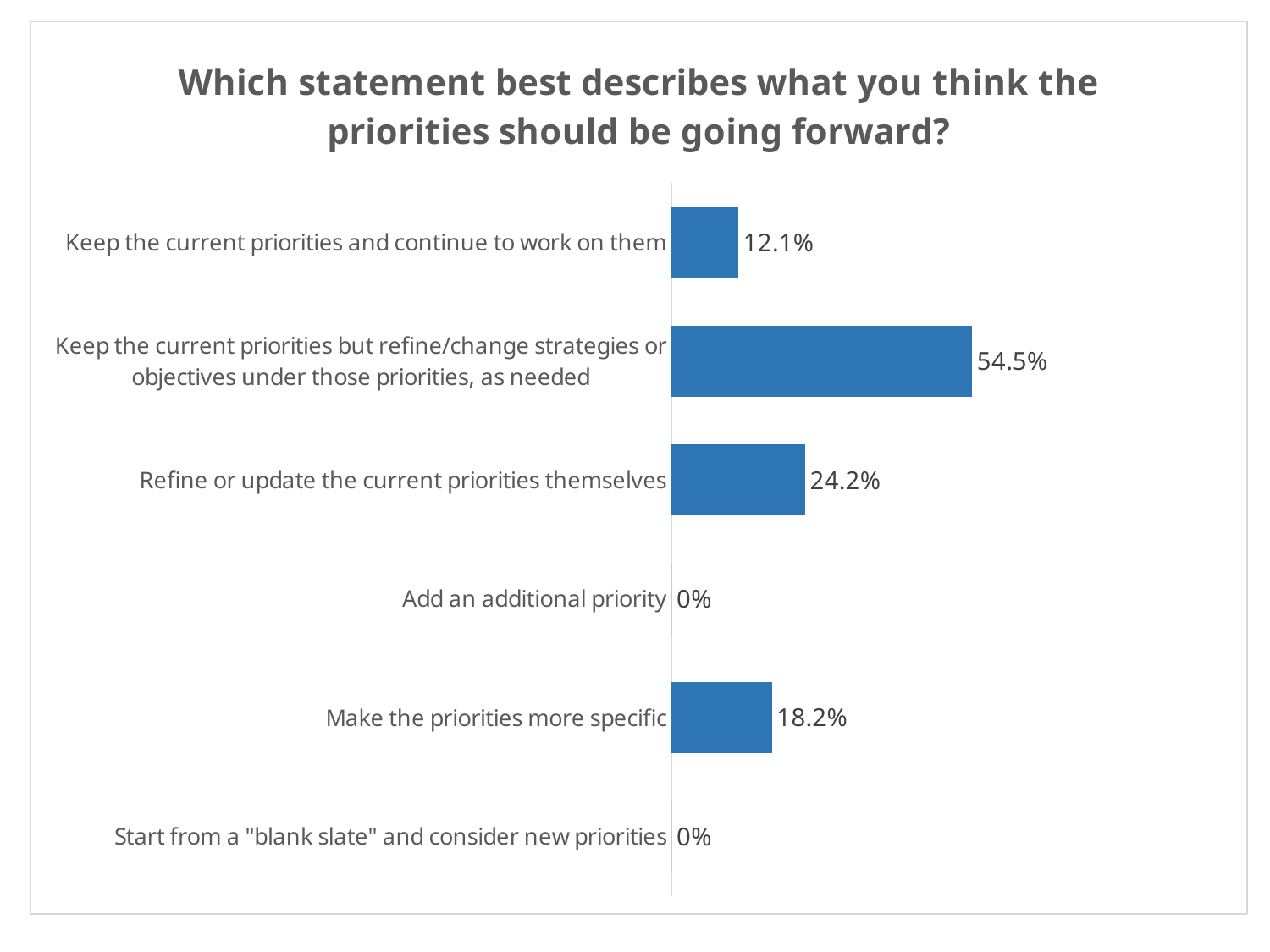
What is the title of the chart? Which statement best describes what you think the priorities should be going forward? Which statement received the highest share of responses? Keep the current priorities but refine/change strategies or objectives under those priorities, as needed What is the value for "Add an additional priority"? 0% What is the value for "Refine or update the current priorities themselves"? 24.2% What type of chart is shown on the slide? Bar chart How many statements (categories) are shown in the chart? 6 What percentage of respondents chose "Keep the current priorities and continue to work on them"? 12.1% What is the value for "Make the priorities more specific"? 18.2% Which is larger: the value for "Refine or update the current priorities themselves" or the value for "Make the priorities more specific"? Refine or update the current priorities themselves What is the difference between the values for "Make the priorities more specific" and "Keep the current priorities and continue to work on them"? 6.1% How many categories have a value of 0%? 2 What is the difference between the values for "Keep the current priorities but refine/change strategies or objectives under those priorities, as needed" and "Refine or update the current priorities themselves"? 30.3%